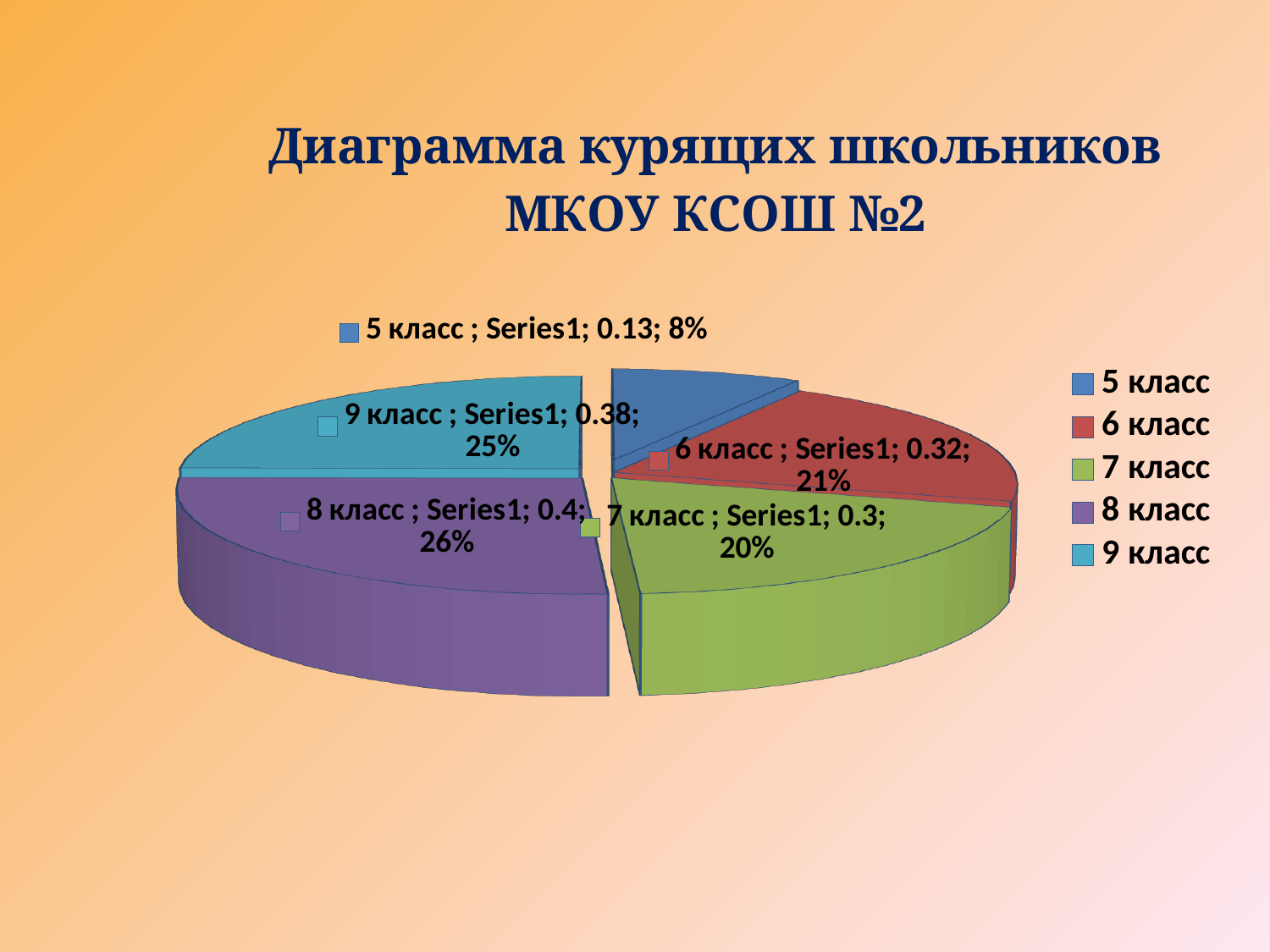
How many classes (slices) are shown in the pie chart? 5 What is the value for 8 класс? 0.4 What is the value for 9 класс? 0.38 Which class has the smallest slice of the pie? 5 класс Which class has the largest slice of the pie? 8 класс What percentage share of the pie does 6 класс have? 21% What is the title of the chart on the slide? Диаграмма курящих школьников МКОУ КСОШ №2 What is the value for 5 класс? 0.13 What kind of chart is shown on the slide? pie chart What is the difference between the value for 8 класс and the value for 5 класс? 0.27 Which is larger, the value for 6 класс or the value for 7 класс? 6 класс What percentage share of the pie does 7 класс have? 20%